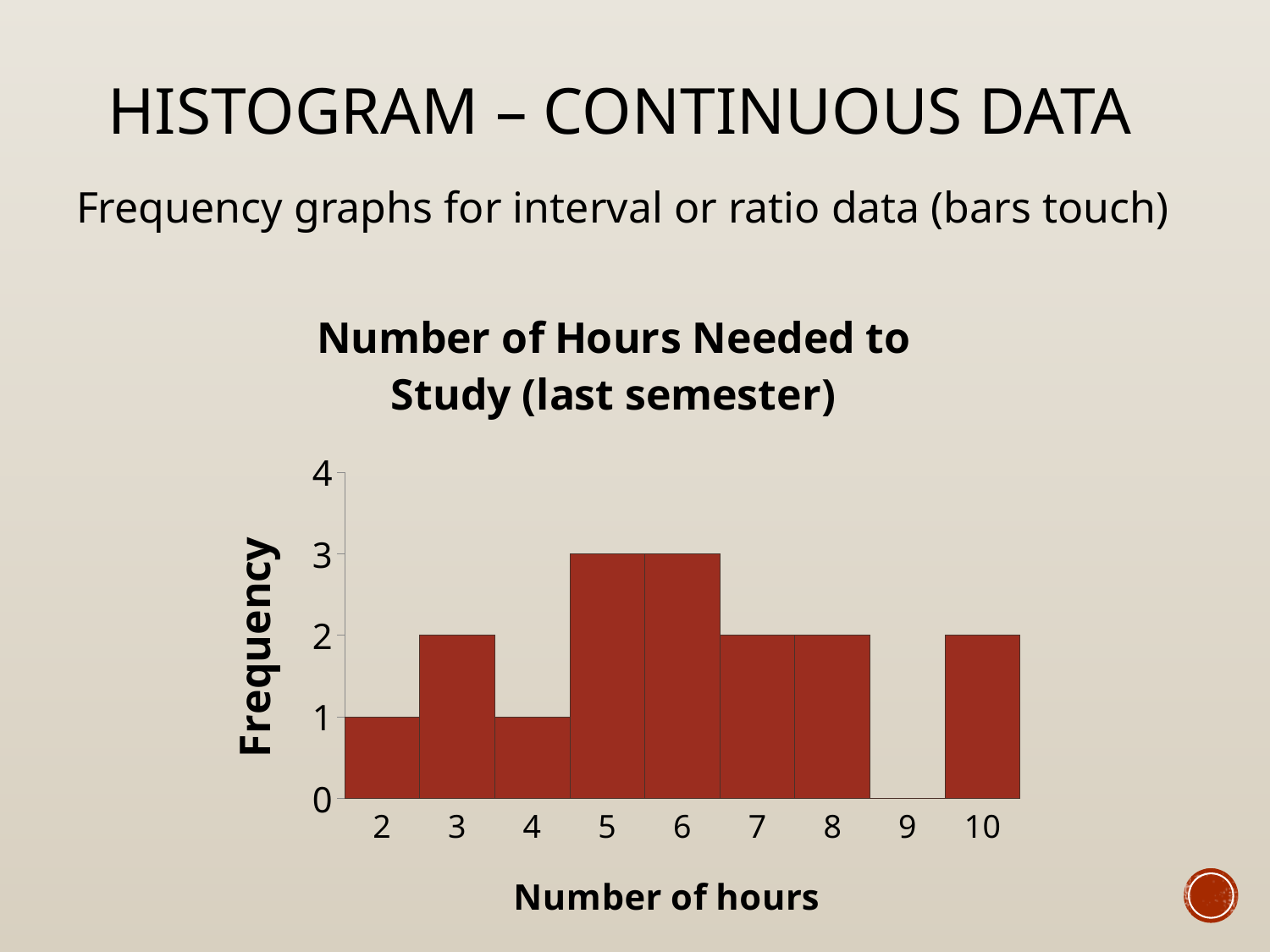
What is the frequency for 9 hours? 0 What is the title of the chart? Number of Hours Needed to Study (last semester) What kind of chart is shown on the slide? Bar chart (histogram) How many number-of-hours categories are shown on the x axis? 9 What is the highest frequency value shown on the chart? 3 What is the label of the y axis? Frequency What is the frequency for 2 hours? 1 Which number of hours has the lowest frequency? 9 What is the frequency for 10 hours? 2 What is the frequency for 5 hours? 3 What is the difference between the frequency for 6 hours and the frequency for 4 hours? 2 Which has a higher frequency, 3 hours or 5 hours? 5 hours